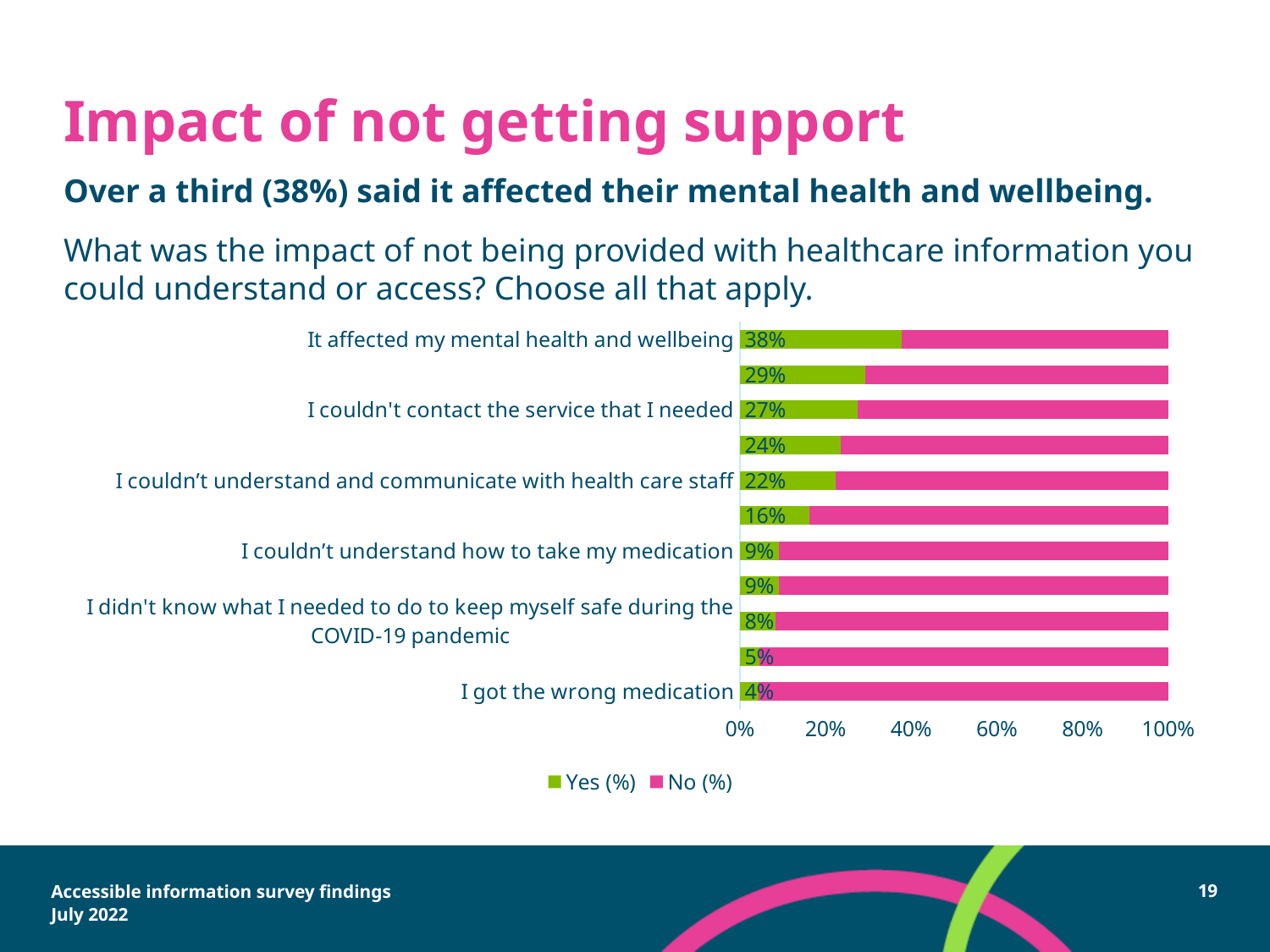
How many series does the legend list? 2 Which impact has the highest Yes (%) value? It affected my mental health and wellbeing How many bars are plotted in the chart? 11 What percentage said it affected their mental health and wellbeing (Yes)? 38% Which has a larger Yes (%) value: "I couldn't understand and communicate with health care staff" or "I couldn't understand how to take my medication"? I couldn't understand and communicate with health care staff What is the Yes (%) value for "I couldn't understand and communicate with health care staff"? 22% Which colour represents the "Yes (%)" series in the chart? Green What is the Yes (%) value for "I got the wrong medication"? 4% What type of chart is shown on the slide? Stacked bar chart What is the Yes (%) value for "I couldn't contact the service that I needed"? 27% Which impact has the lowest Yes (%) value? I got the wrong medication What is the difference in Yes (%) between "It affected my mental health and wellbeing" and "I couldn't contact the service that I needed"? 11 percentage points